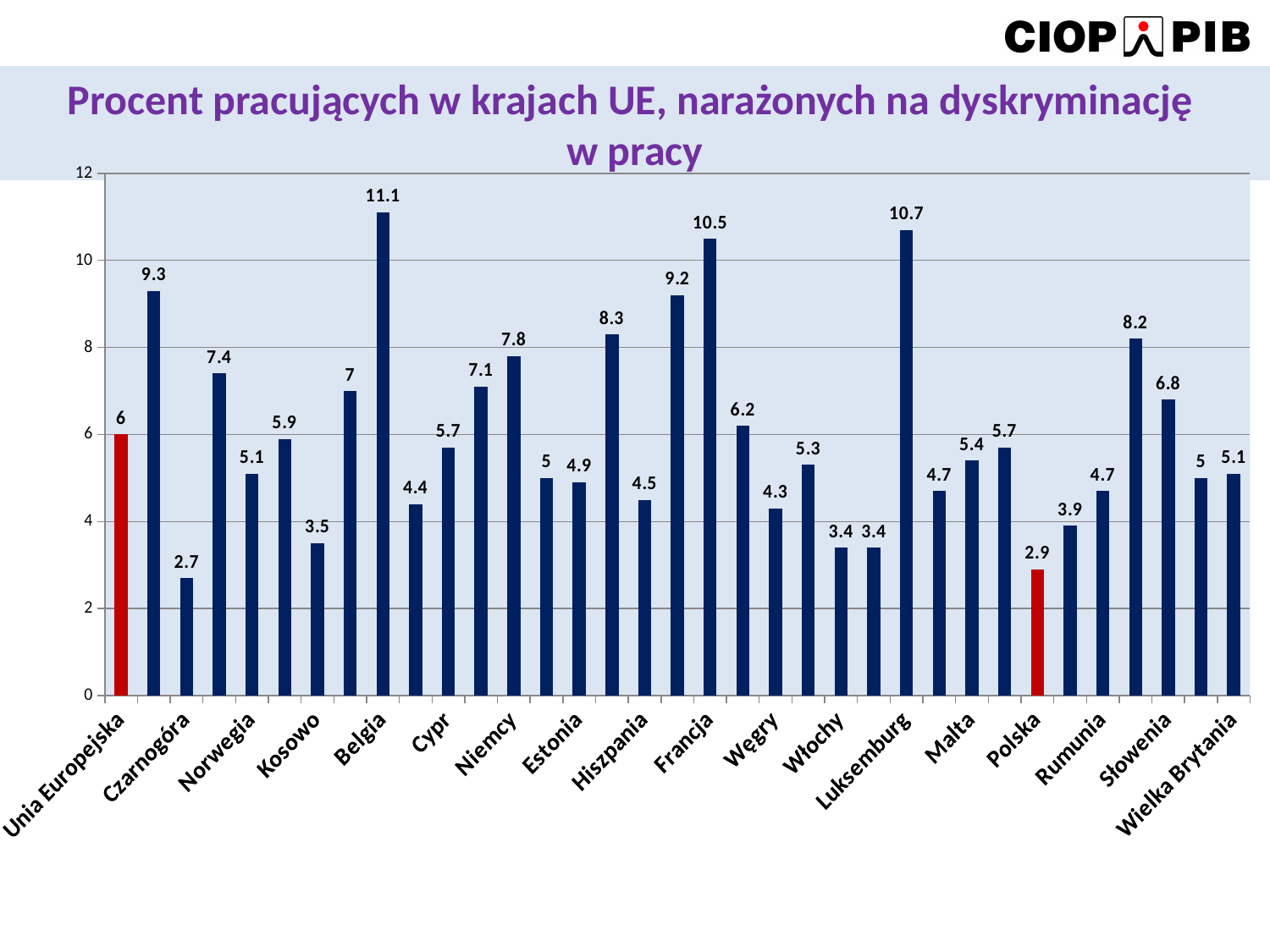
What is the title of the chart? Procent pracujących w krajach UE, narażonych na dyskryminację w pracy What is the value for Polska? 2.9 What kind of chart is shown on the slide? bar chart Which has a larger value, Francja or Luksemburg? Luksemburg What is the difference between the values for Belgia and Polska? 8.2 What is the value for Niemcy? 7.8 Is the value for Słowenia greater or less than 6? greater Which labelled country has the lowest value? Czarnogóra Which two bars are coloured red? Unia Europejska and Polska Which labelled country has the highest value? Belgia What is the value for Luksemburg? 10.7 What is the value for Unia Europejska? 6